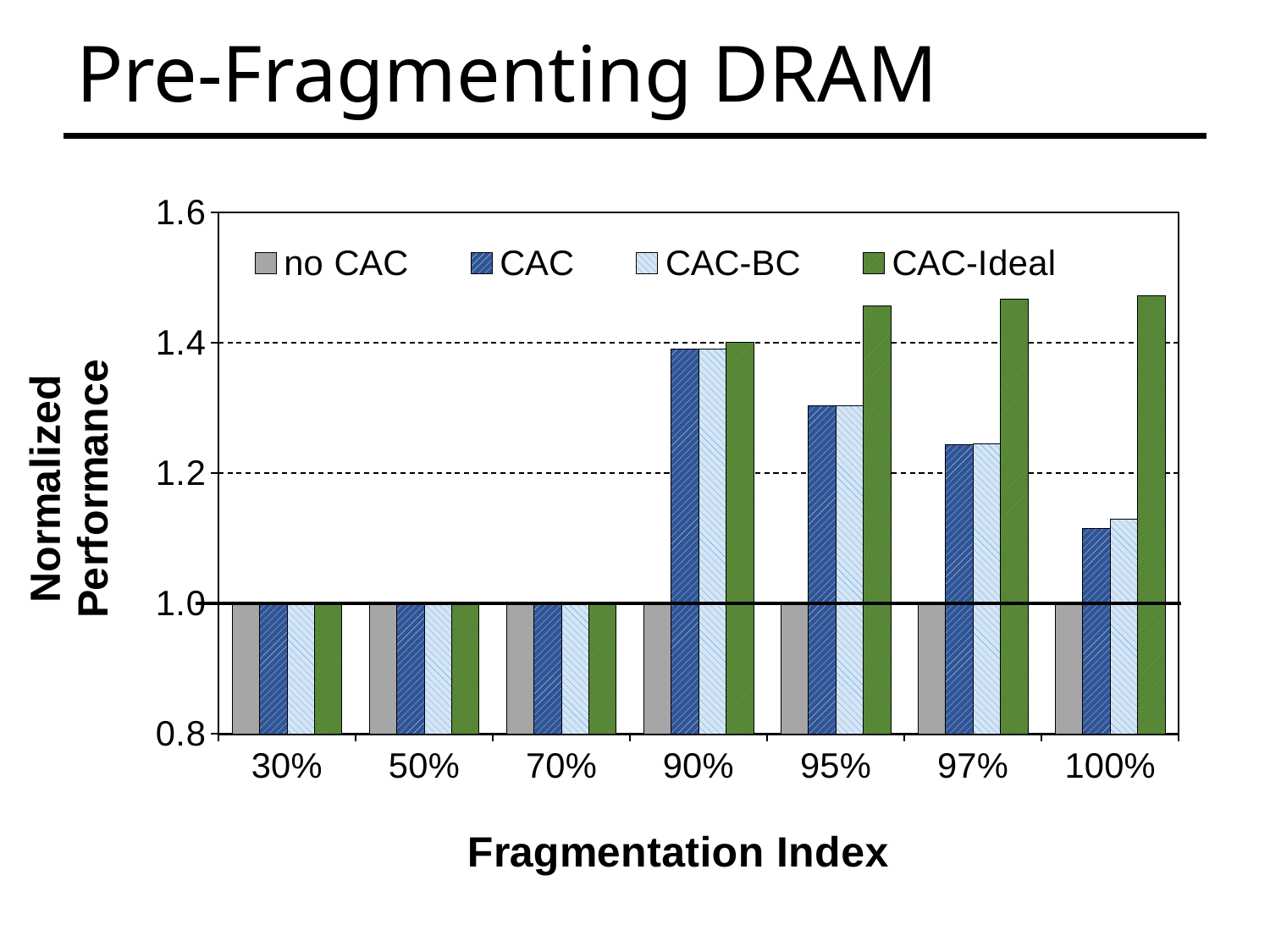
How many fragmentation index categories are shown on the x axis? 7 What kind of chart is shown on the slide? bar chart Is the value for CAC-Ideal at 100% fragmentation index greater or less than 1.4? greater Is the value for CAC at 100% fragmentation index greater or less than 1.2? less What is the normalized performance of no CAC at 100% fragmentation index? 1.0 Is the value for CAC at 95% fragmentation index greater or less than 1.2? greater Which series has the highest value at 97% fragmentation index? CAC-Ideal Which is larger at 100% fragmentation index, CAC or CAC-Ideal? CAC-Ideal What is the label of the x axis? Fragmentation Index Do the CAC values rise or fall from 90% to 100% fragmentation index? fall What is the normalized performance of CAC-Ideal at 90% fragmentation index? 1.4 How many series does the legend list? 4